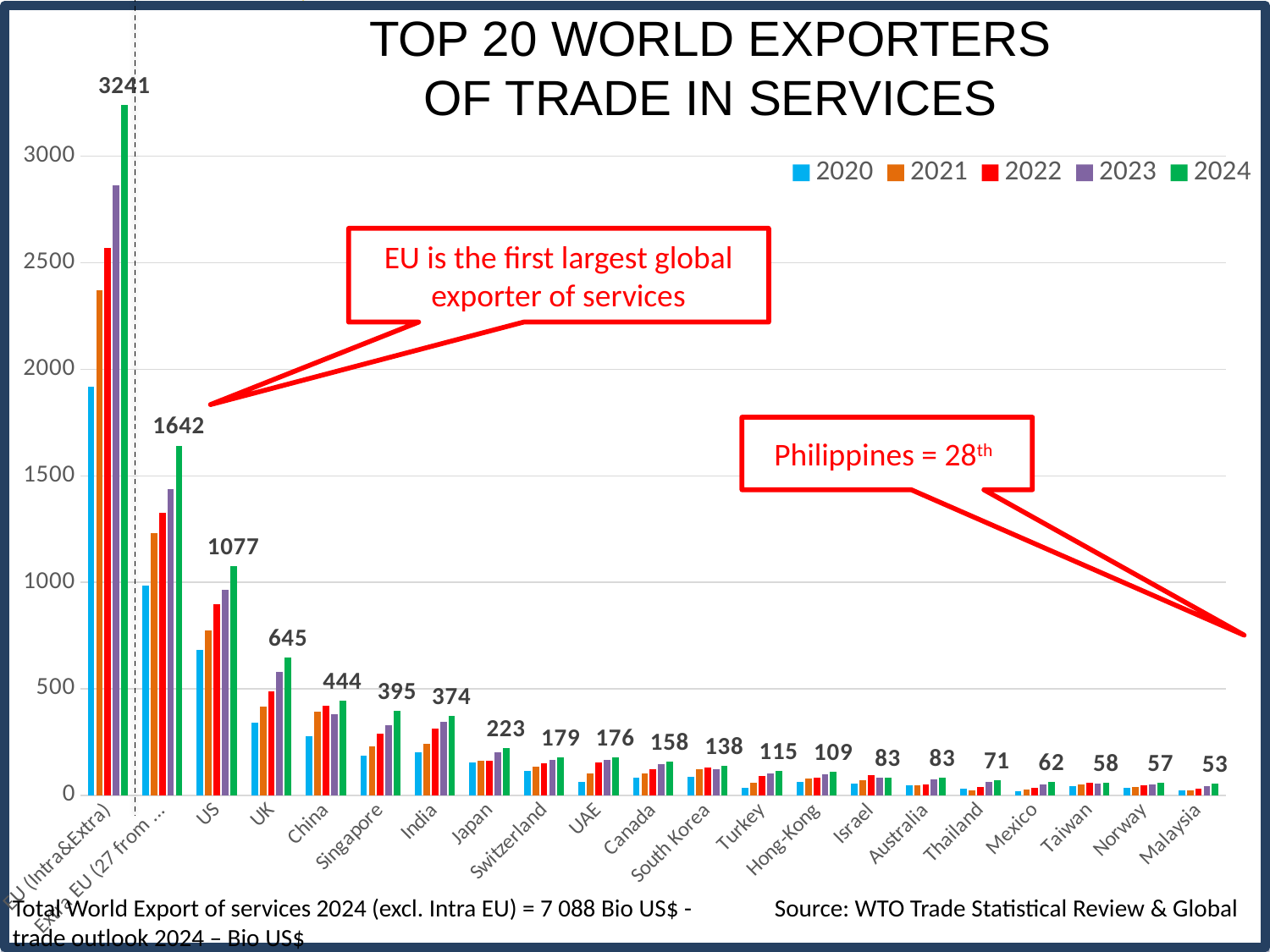
What kind of chart is shown? bar chart Is the 2020 value for the US greater or less than 1000? less How many series does the legend list? 5 What is the difference between the 2024 values for the US and the UK? 432 Do the values for EU (Intra&Extra) rise or fall from 2020 to 2024? rise Which exporter has the highest 2024 value? EU (Intra&Extra) Which exporter has the lowest 2024 value? Malaysia What is the 2024 value for Switzerland? 179 Which has the larger 2024 value, Japan or India? India What is the 2024 value for Singapore? 395 How many exporters are shown on the x axis? 21 What is the 2024 value for the US? 1077